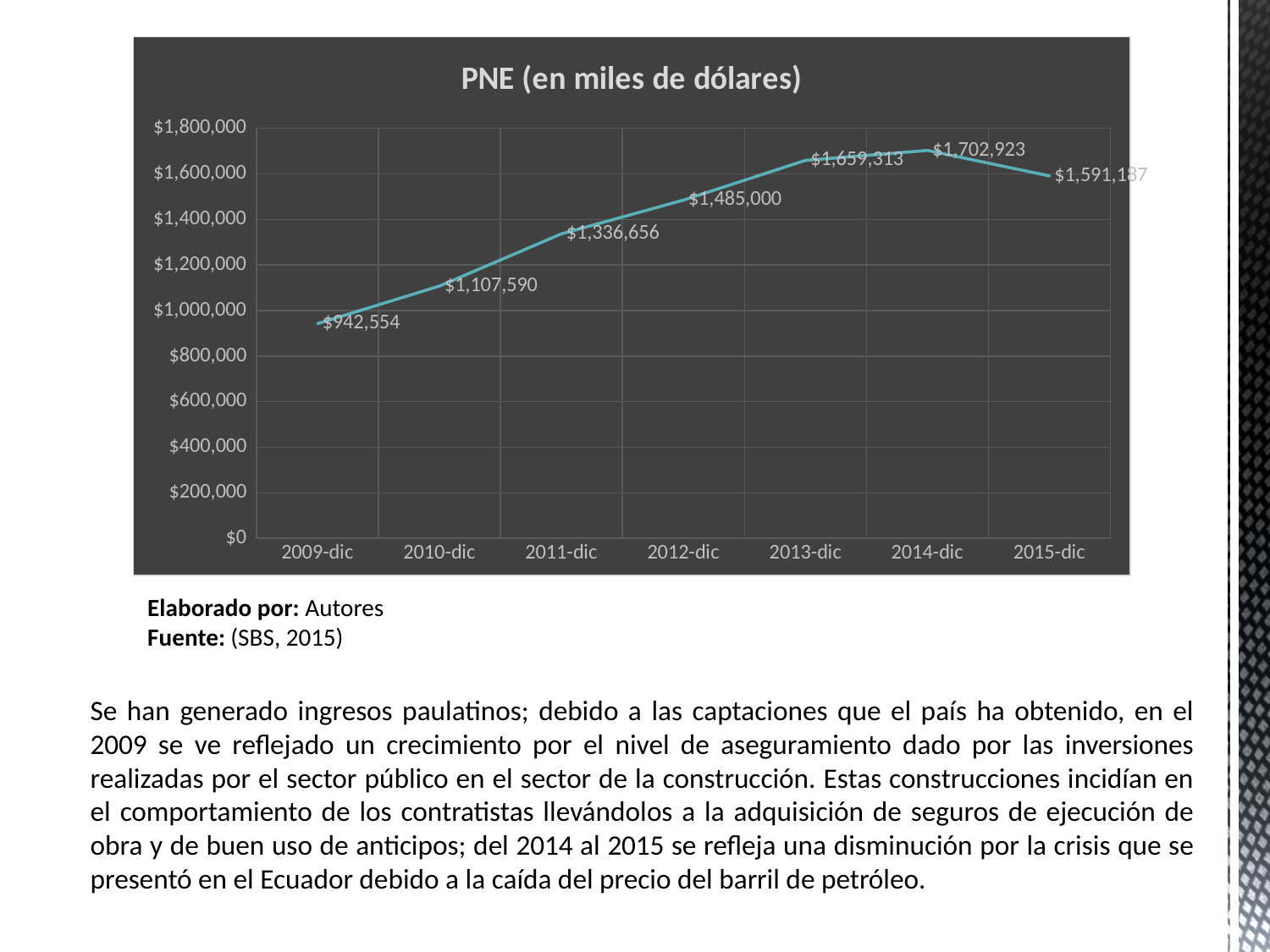
What is the PNE value for 2014-dic? $1,702,923 Which is larger, the PNE value for 2013-dic or for 2015-dic? 2013-dic What is the PNE value for 2012-dic? $1,485,000 What is the title of the chart? PNE (en miles de dólares) What is the PNE value for 2009-dic? $942,554 What is the difference between the PNE values for 2010-dic and 2009-dic? $165,036 Is the PNE value for 2015-dic greater or less than $1,400,000? greater Which period has the highest PNE value? 2014-dic What is the difference between the PNE values for 2014-dic and 2013-dic? $43,610 Which period has the lowest PNE value? 2009-dic What kind of chart is shown on the slide? Line chart How many data points are plotted on the chart? 7